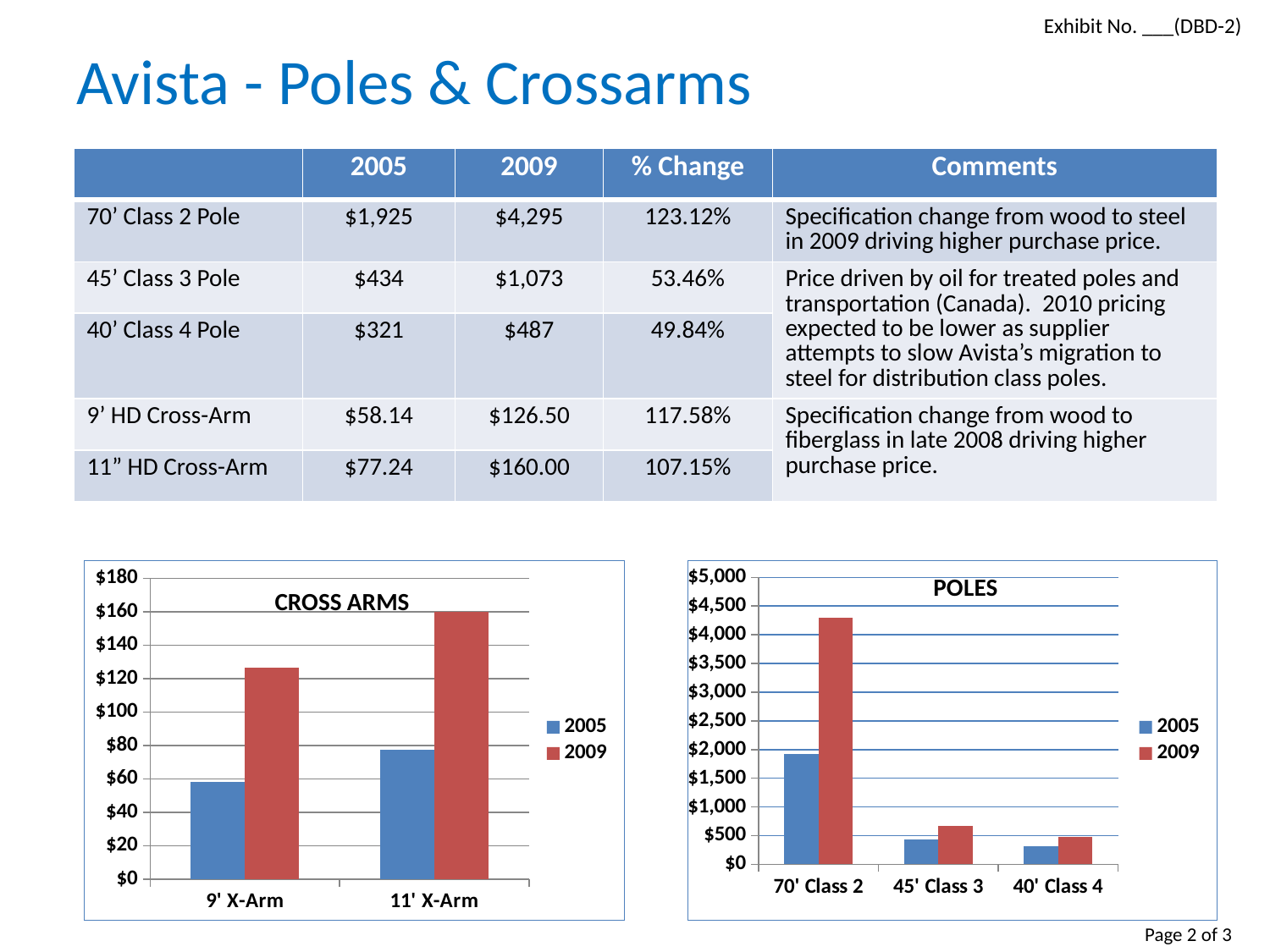
How many categories are shown on the x axis of the POLES chart? 3 In the CROSS ARMS chart, which is larger for 9' X-Arm: the 2005 value or the 2009 value? 2009 In the POLES chart, which category has the lowest 2005 value? 40' Class 4 In the POLES chart, is the 2005 value for 70' Class 2 greater or less than $1,500? greater In the POLES chart, is the 2009 value for 70' Class 2 greater or less than $4,000? greater How many series does the legend of the POLES chart list? 2 In the POLES chart, which colour represents the 2009 series? red What kind of chart is the CROSS ARMS chart? bar chart In the POLES chart, which category has the highest 2009 value? 70' Class 2 In the CROSS ARMS chart, what is the 2009 value for 11' X-Arm? $160 In the CROSS ARMS chart, is the 2005 value for 9' X-Arm greater or less than $80? less How many categories are shown on the x axis of the CROSS ARMS chart? 2